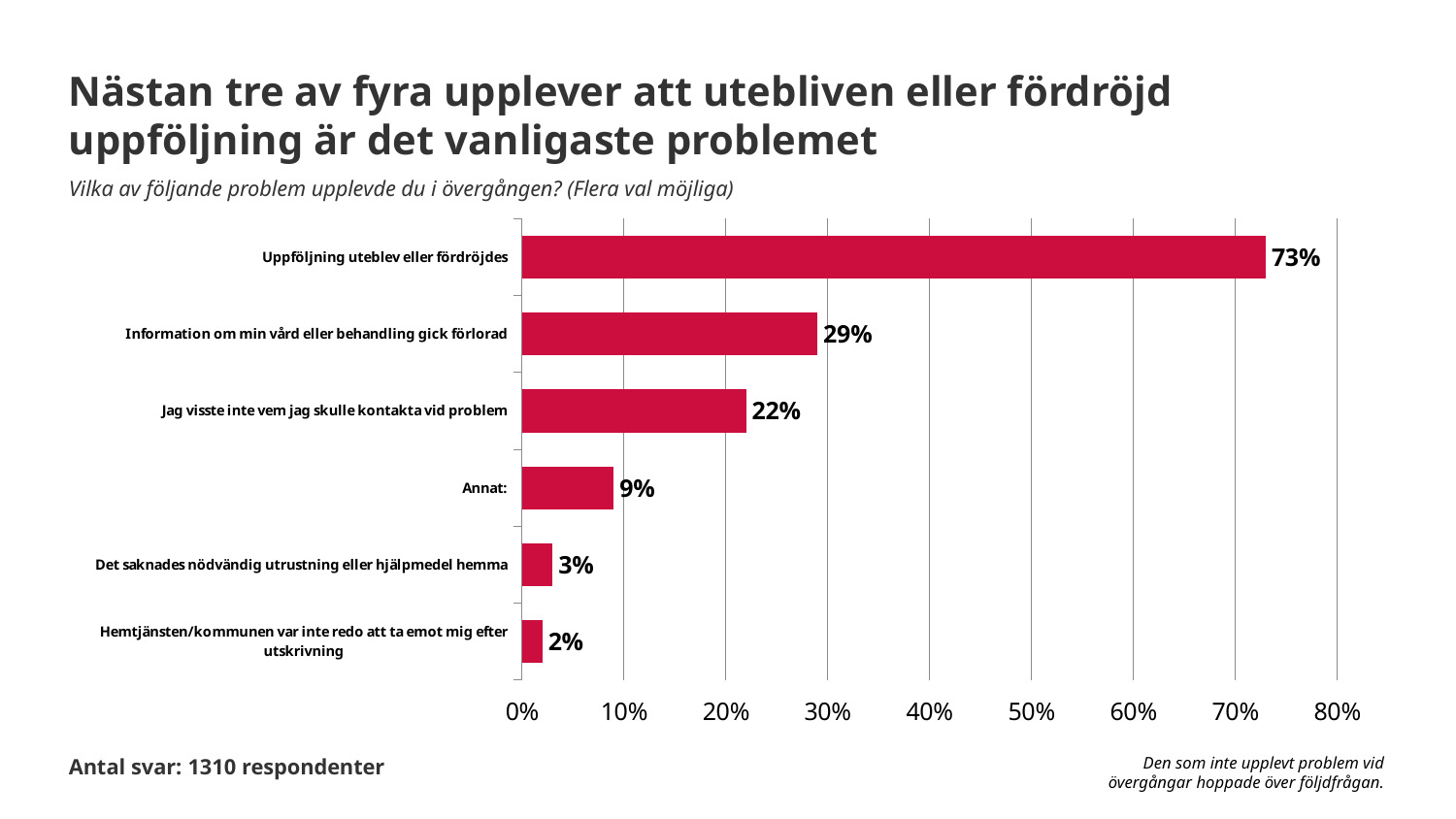
What is the value for "Information om min vård eller behandling gick förlorad"? 29% What type of chart is shown on the slide? Bar chart Which category has the lowest value? Hemtjänsten/kommunen var inte redo att ta emot mig efter utskrivning Which category has the highest value? Uppföljning uteblev eller fördröjdes How many respondents answered the survey, according to the slide? 1310 respondenter What percentage of respondents reported "Uppföljning uteblev eller fördröjdes"? 73% What is the value for "Annat:"? 9% What is the difference between the values for "Uppföljning uteblev eller fördröjdes" and "Information om min vård eller behandling gick förlorad"? 44 percentage points Is the value for "Jag visste inte vem jag skulle kontakta vid problem" greater or less than 30%? less What percentage is shown for "Jag visste inte vem jag skulle kontakta vid problem"? 22% Which is larger: the value for "Det saknades nödvändig utrustning eller hjälpmedel hemma" or for "Hemtjänsten/kommunen var inte redo att ta emot mig efter utskrivning"? Det saknades nödvändig utrustning eller hjälpmedel hemma How many categories are shown in the chart? 6